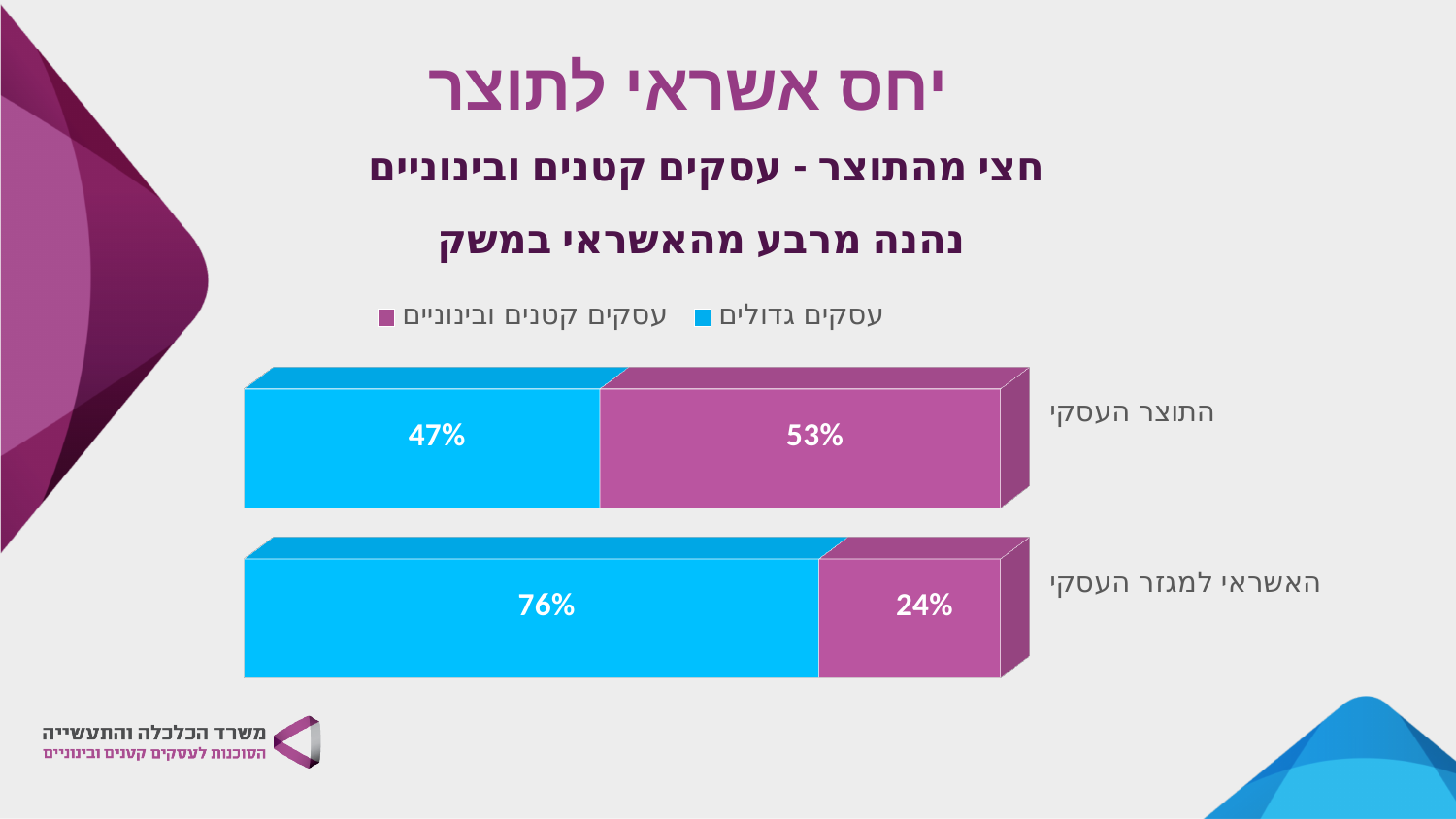
What is the total of the התוצר העסקי stacked bar? 100% How many categories (bars) does the chart show? 2 What is the difference between the עסקים גדולים share of האשראי למגזר העסקי and their share of התוצר העסקי? 29% What kind of chart is shown on the slide? Stacked bar chart What share of התוצר העסקי is attributed to עסקים גדולים? 47% Which colour represents עסקים קטנים ובינוניים in the chart? Purple What share of האשראי למגזר העסקי goes to עסקים גדולים? 76% How many series does the legend list? 2 In which category do עסקים קטנים ובינוניים have the larger share: התוצר העסקי or האשראי למגזר העסקי? התוצר העסקי What is the difference between the two segments in the האשראי למגזר העסקי bar? 52% What share of האשראי למגזר העסקי goes to עסקים קטנים ובינוניים? 24% What share of התוצר העסקי is attributed to עסקים קטנים ובינוניים? 53%